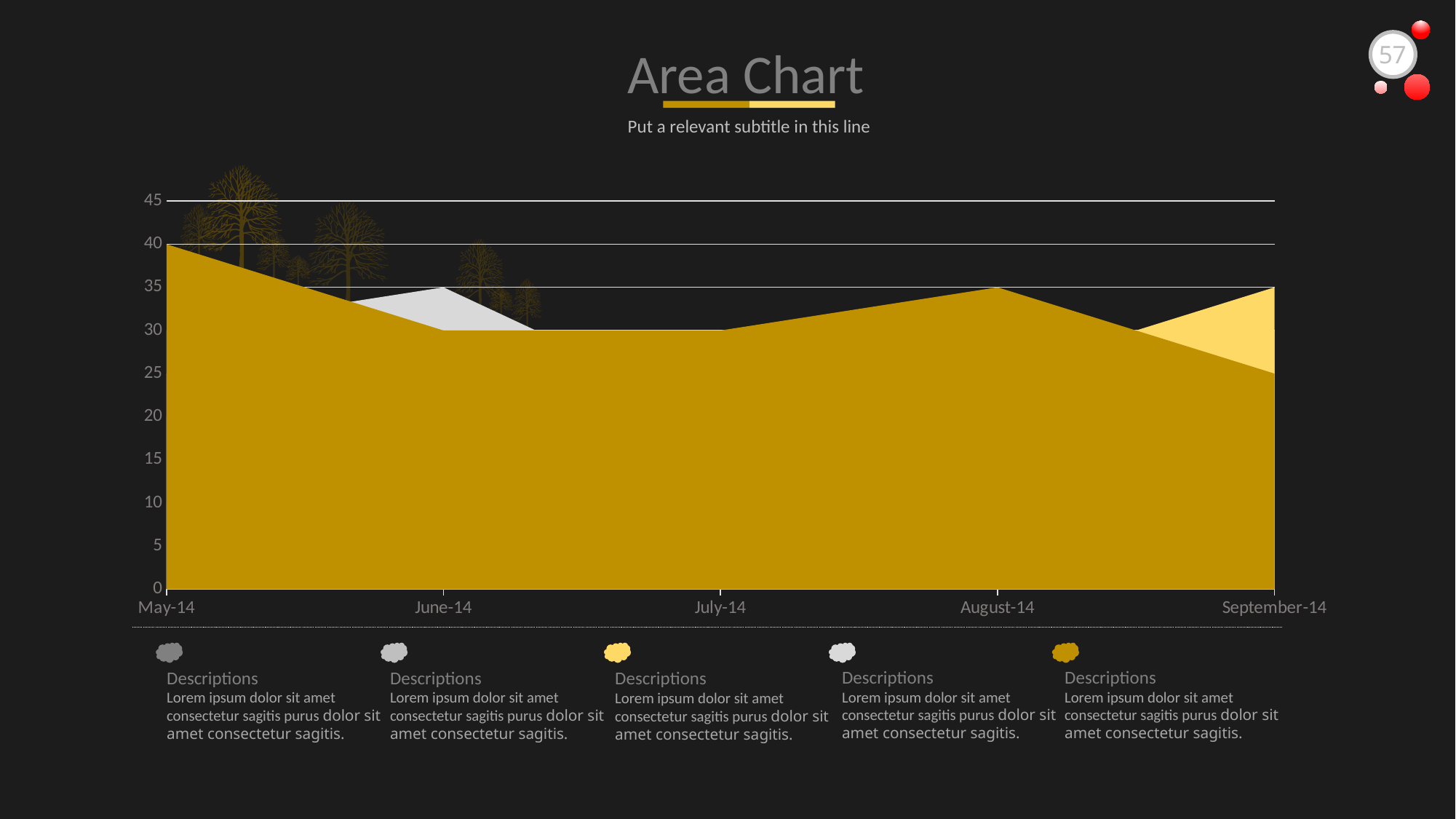
What is the value of the dark gold area at May-14? 40 How many months are shown on the x axis of the chart? 5 What is the value of the light yellow area at September-14? 35 At which month is the dark gold area highest? May-14 What is the difference between the dark gold values at May-14 and September-14? 15 Which month has the larger dark gold value, May-14 or August-14? May-14 What is the value of the dark gold area at August-14? 35 At which month is the dark gold area lowest? September-14 What is the value of the dark gold area at September-14? 25 What kind of chart is shown on the slide? area chart What is the title of the chart on the slide? Area Chart Is the value of the dark gold area at July-14 greater or less than 35? less